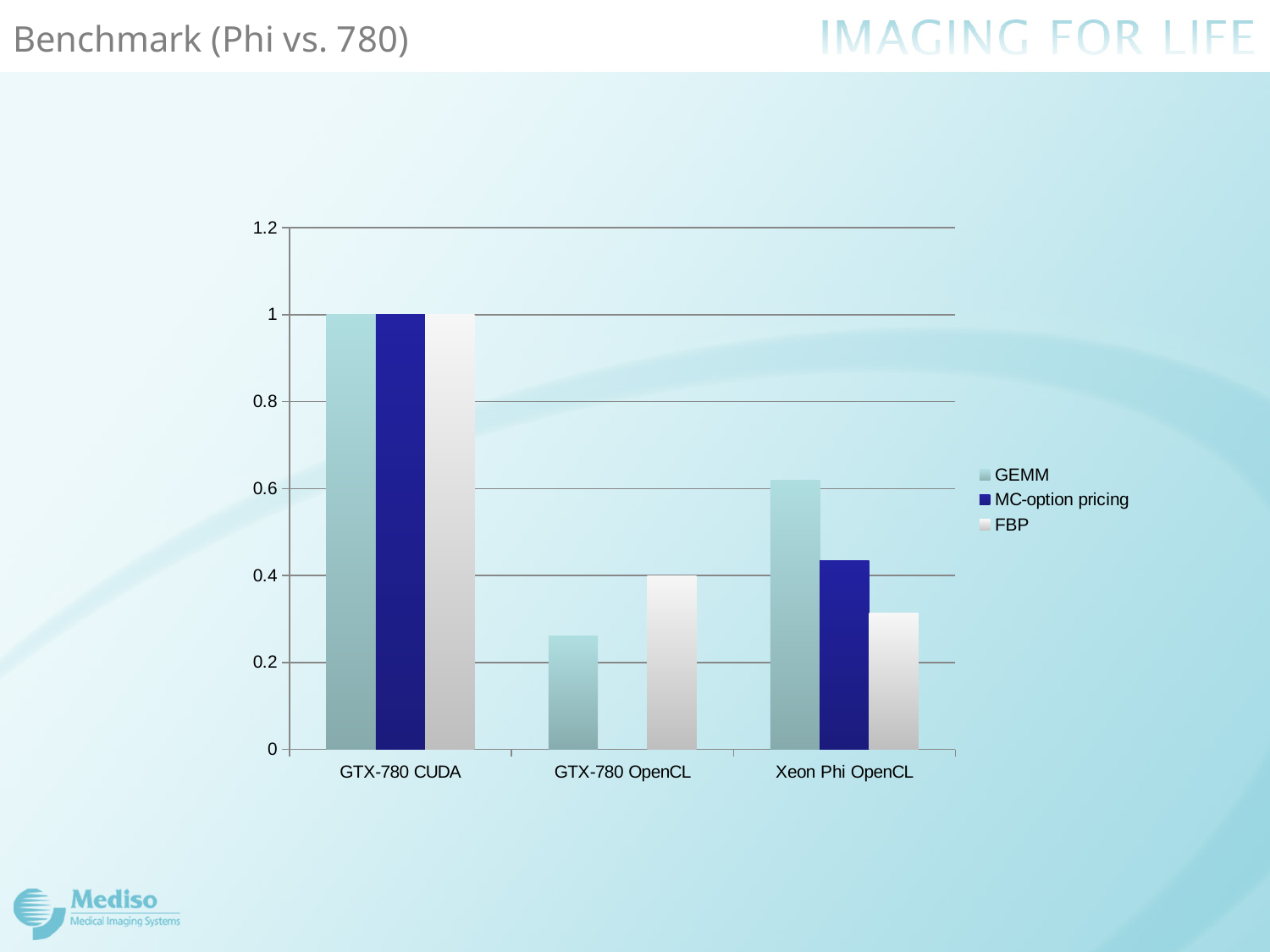
How many categories are shown on the x axis? 3 What is the FBP value for GTX-780 OpenCL? 0.4 What is the GEMM value for GTX-780 CUDA? 1 Which series has the lowest value for Xeon Phi OpenCL? FBP Is the MC-option pricing value for Xeon Phi OpenCL greater or less than 0.6? less Is the GEMM value for GTX-780 OpenCL greater or less than 0.4? less Which is larger, the GEMM value for GTX-780 OpenCL or the GEMM value for Xeon Phi OpenCL? Xeon Phi OpenCL What is the title of the slide containing the chart? Benchmark (Phi vs. 780) What kind of chart is shown on the slide? bar chart How many series does the legend list? 3 Is the GEMM value for Xeon Phi OpenCL greater or less than 0.4? greater Which series has the highest value for Xeon Phi OpenCL? GEMM